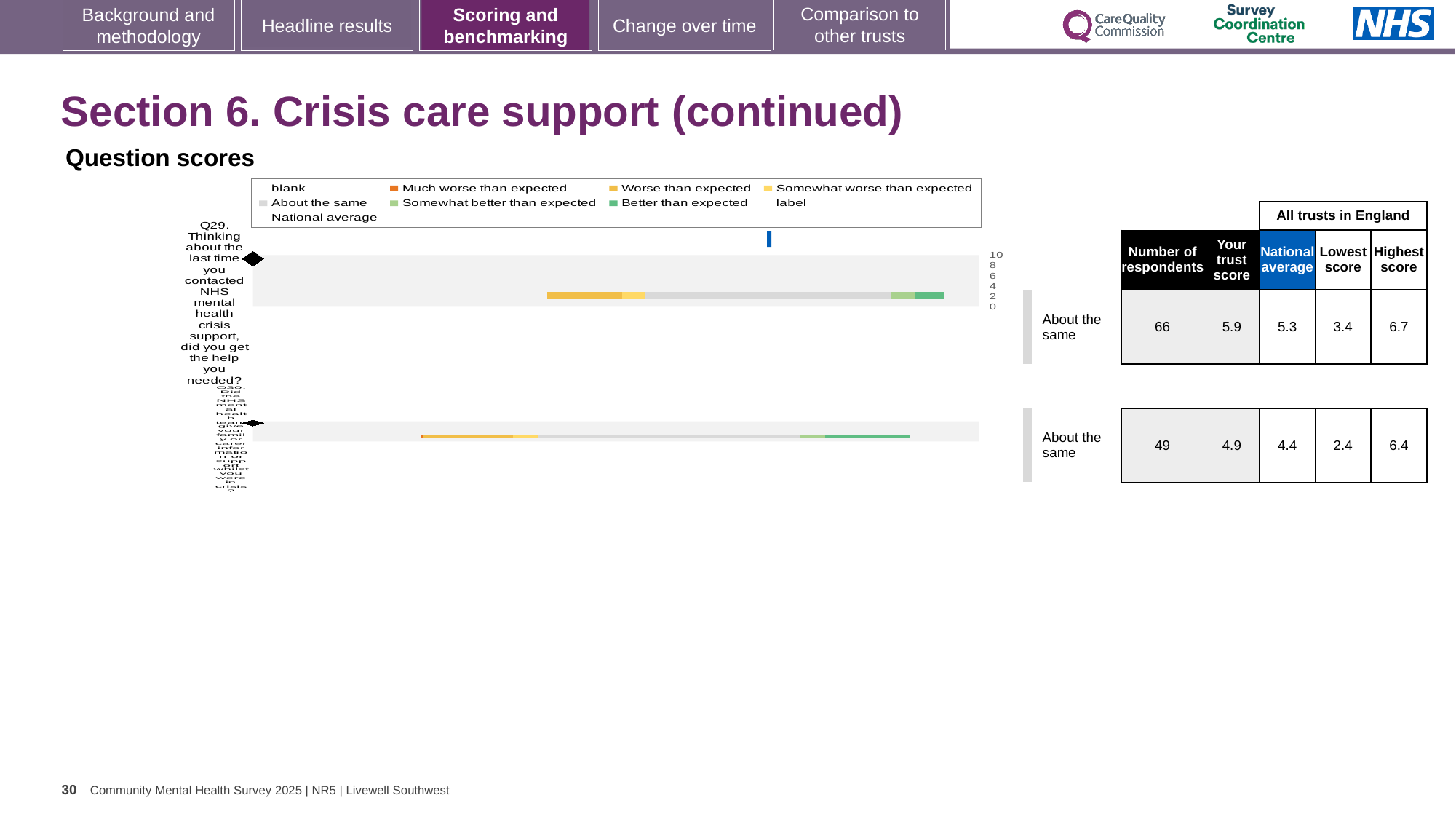
What is the national average for Q30 in the question scores chart? 4.4 Which question has the higher trust score, Q29 or Q30? Q29 What benchmark category is shown for Q30 in the question scores chart? About the same What is the trust score for Q30 in the question scores chart? 4.9 For Q29, which is larger: the trust score or the national average? the trust score How many questions are plotted in the question scores chart? 2 How many respondents answered Q29? 66 How many entries does the legend of the question scores chart list? 9 What is the trust score for Q29 in the question scores chart? 5.9 What kind of chart is used to show the question scores on this slide? bar chart What is the difference between the highest score and the lowest score for Q29? 3.3 What is the national average for Q29 in the question scores chart? 5.3